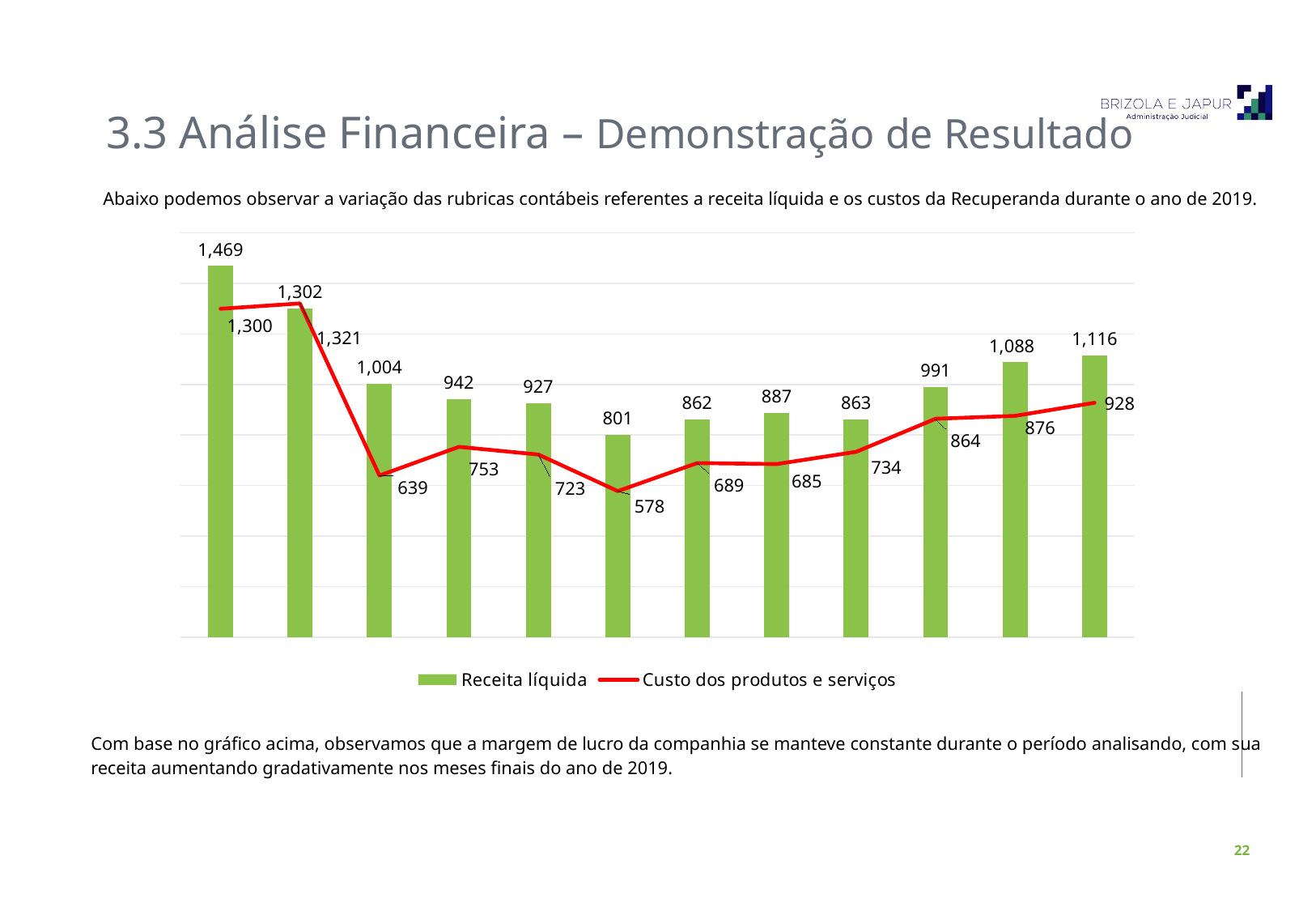
What is the highest value shown on the Custo dos produtos e serviços line? 1,321 How many bars does the chart contain? 12 Which series is drawn as a red line in the chart? Custo dos produtos e serviços What is the highest value shown for Receita líquida? 1,469 What is the value of the first (leftmost) bar for Receita líquida? 1,469 What is the value of the last (rightmost) bar for Receita líquida? 1,116 What is the lowest value shown on the Custo dos produtos e serviços line? 578 What is the lowest value shown for Receita líquida? 801 What kind of chart is shown on the slide? Combined bar and line chart How many series does the legend list? 2 What is the last (rightmost) value of the Custo dos produtos e serviços line? 928 What is the difference between the first bar (1,469) and the last bar (1,116) for Receita líquida? 353